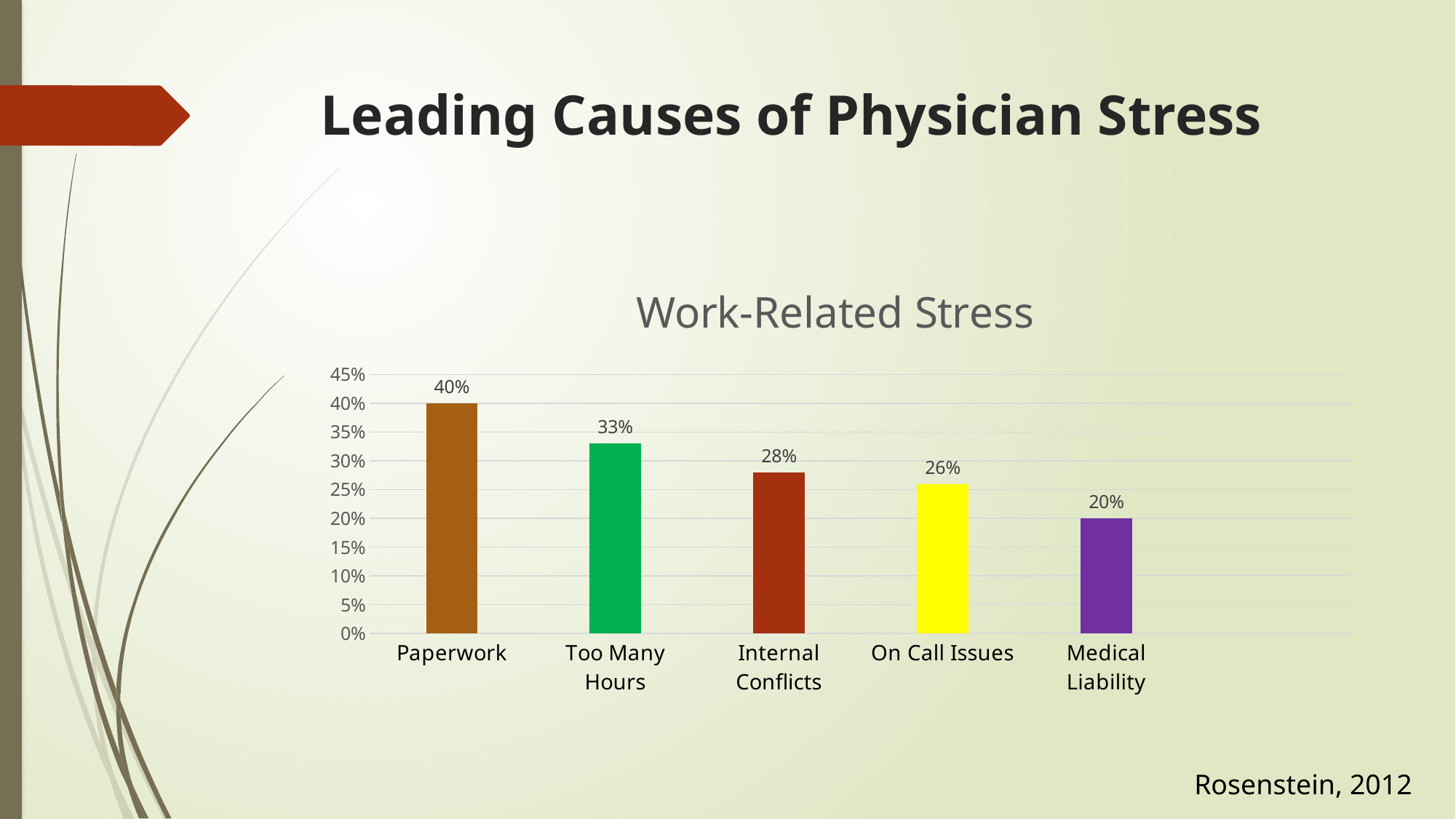
What is the difference between the values for Too Many Hours and On Call Issues? 7% Which category has the highest value? Paperwork What is the value for Medical Liability? 20% What is the value for Internal Conflicts? 28% How many categories are shown in the chart? 5 What is the value for Too Many Hours? 33% What is the title of the chart? Work-Related Stress What is the difference between the values for Paperwork and Medical Liability? 20% What kind of chart is shown on the slide? Bar chart Which category has the lowest value? Medical Liability Which is larger, the value for Internal Conflicts or the value for On Call Issues? Internal Conflicts What is the value for Paperwork? 40%